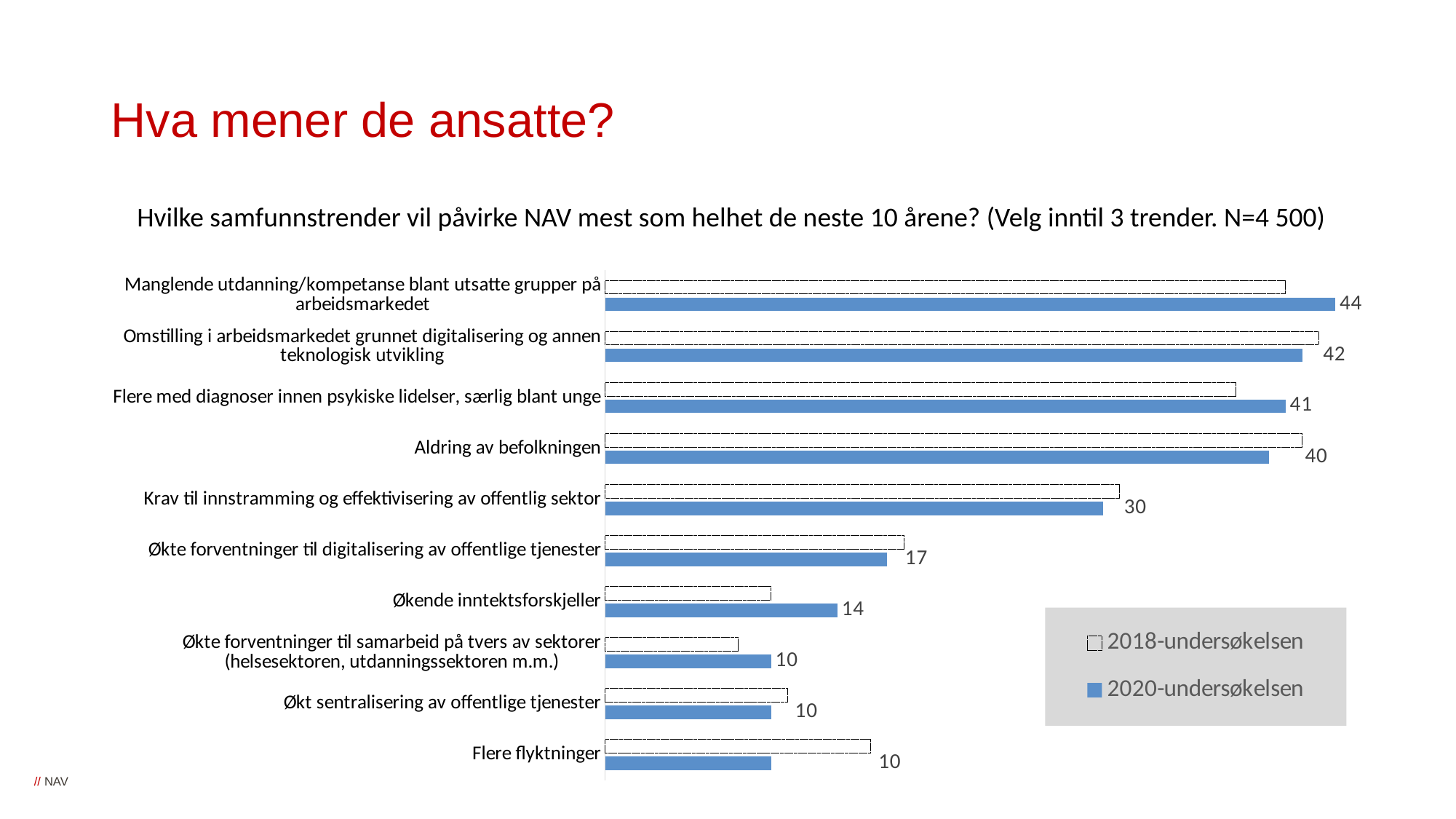
What is the 2020-undersøkelsen value for 'Økende inntektsforskjeller'? 14 What is the lowest 2020-undersøkelsen value shown in the chart? 10 What is the difference between the 2020-undersøkelsen values for 'Manglende utdanning/kompetanse blant utsatte grupper på arbeidsmarkedet' and 'Omstilling i arbeidsmarkedet grunnet digitalisering og annen teknologisk utvikling'? 2 Which legend entry is shown with a solid blue bar? 2020-undersøkelsen For 'Flere flyktninger', which survey has the larger value, 2018-undersøkelsen or 2020-undersøkelsen? 2018-undersøkelsen What is the 2020-undersøkelsen value for 'Krav til innstramming og effektivisering av offentlig sektor'? 30 What is the 2020-undersøkelsen value for 'Aldring av befolkningen'? 40 What is the difference between the 2020-undersøkelsen values for 'Krav til innstramming og effektivisering av offentlig sektor' and 'Økte forventninger til digitalisering av offentlige tjenester'? 13 How many series does the legend list? 2 Which category has the highest 2020-undersøkelsen value? Manglende utdanning/kompetanse blant utsatte grupper på arbeidsmarkedet How many categories (trends) are shown in the chart? 10 What type of chart is shown on the slide? bar chart